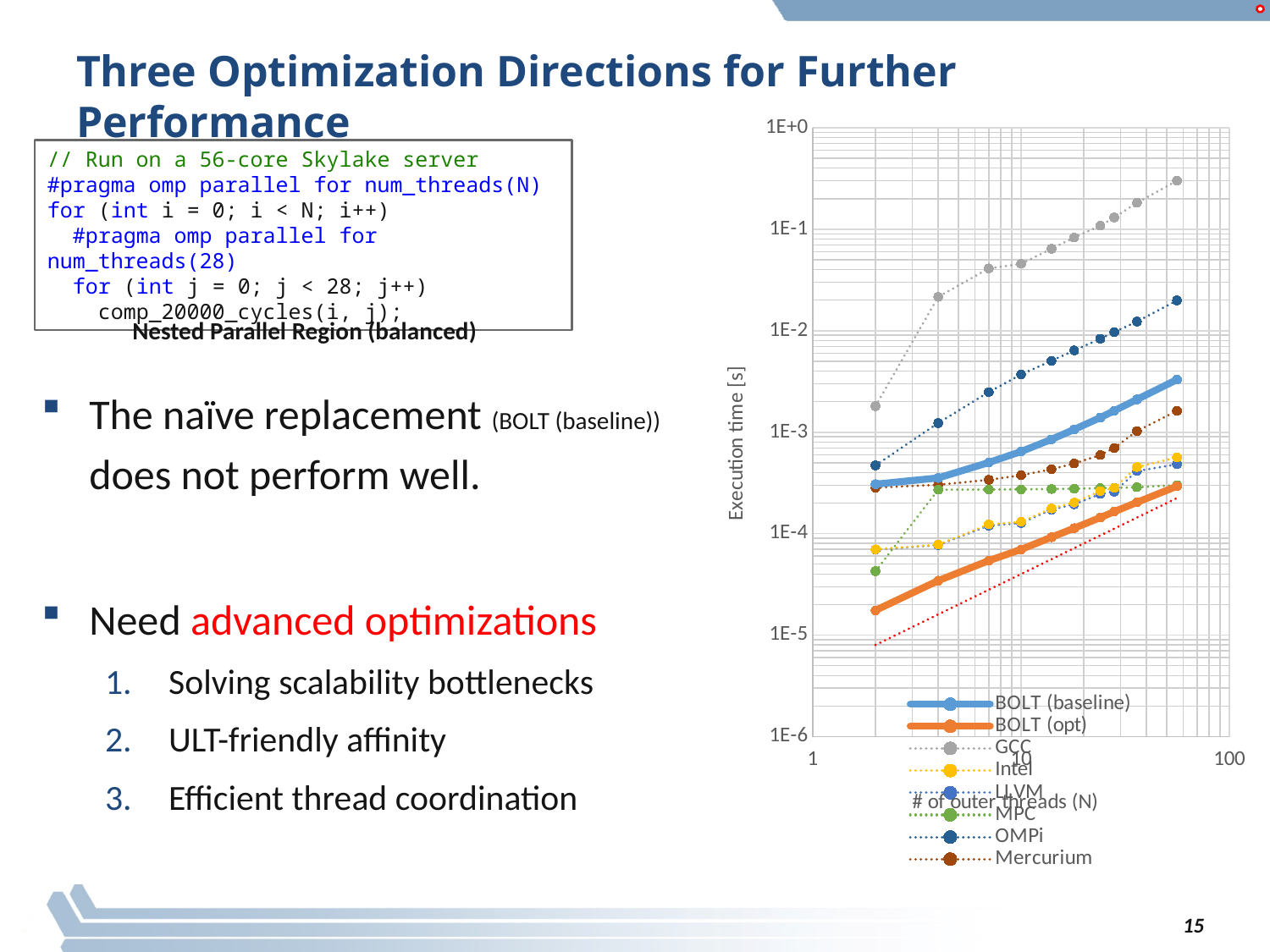
How many series does the chart's legend list? 8 Is the execution time of BOLT (opt) at its leftmost point greater or less than 1E-4? less Is the execution time of GCC at its rightmost point greater or less than 1E-1? greater What kind of chart is shown on the slide? line chart Does the execution time of GCC rise or fall as the number of outer threads increases? rise Is the execution time of BOLT (baseline) at its rightmost point greater or less than 1E-3? greater What is the label of the chart's vertical axis? Execution time [s] At the largest number of outer threads, which has the higher execution time, BOLT (baseline) or BOLT (opt)? BOLT (baseline) What is the label of the chart's horizontal axis? # of outer threads (N) Which series has the highest execution time at the largest number of outer threads? GCC At the largest number of outer threads, which has the higher execution time, OMPi or BOLT (baseline)? OMPi